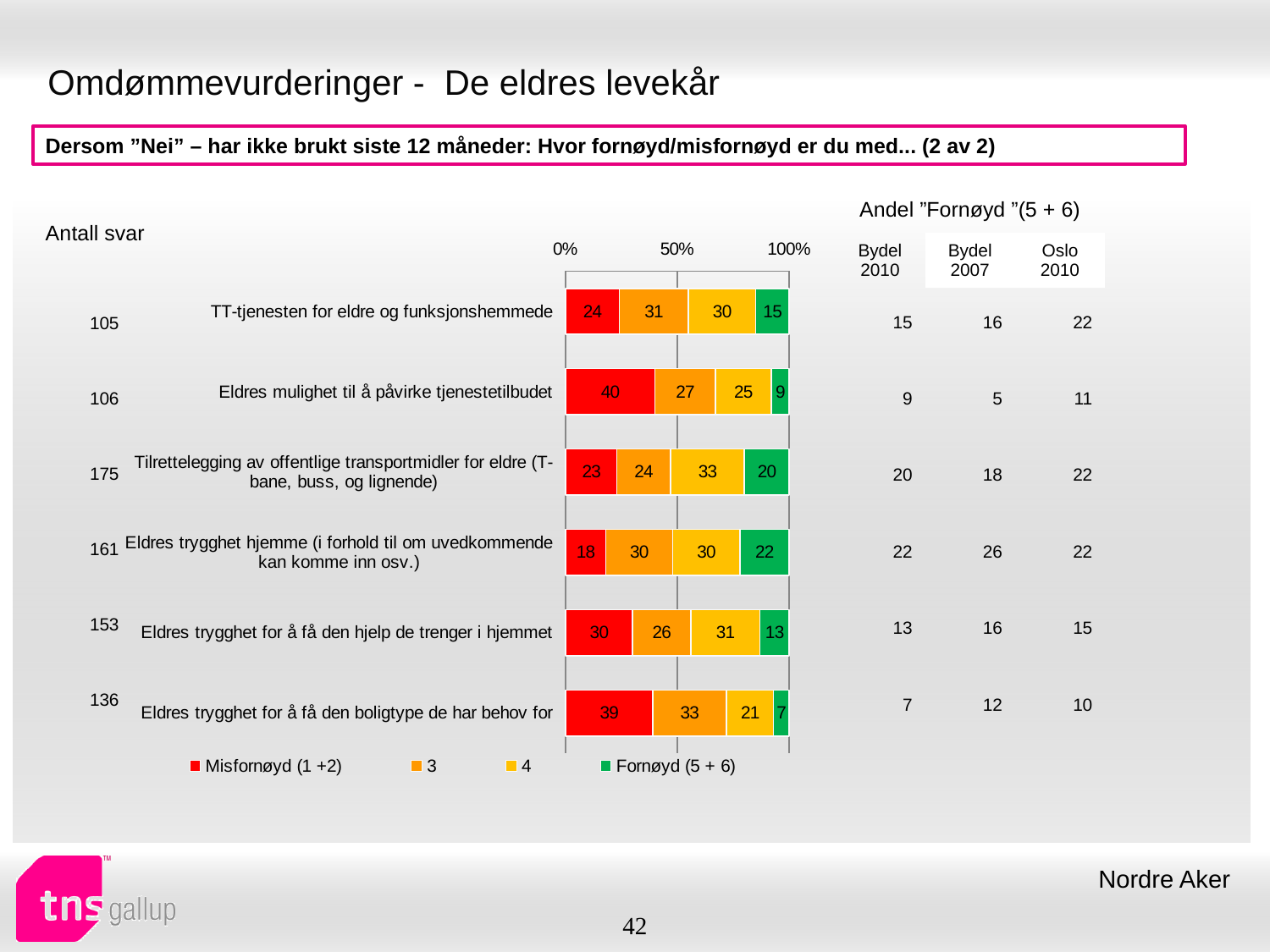
Which category has the highest Misfornøyd (1 +2) value? Eldres mulighet til å påvirke tjenestetilbudet What kind of chart is shown on the slide? Stacked bar chart How many series does the chart legend list? 4 What is the Misfornøyd (1 +2) value for 'TT-tjenesten for eldre og funksjonshemmede'? 24 What is the total of the stacked bar for 'Eldres mulighet til å påvirke tjenestetilbudet'? 101 What is the value of series '4' for 'Tilrettelegging av offentlige transportmidler for eldre (T-bane, buss, og lignende)'? 33 What is the Fornøyd (5 + 6) value for 'Eldres trygghet hjemme (i forhold til om uvedkommende kan komme inn osv.)'? 22 What is the difference between the Misfornøyd (1 +2) values for 'Eldres trygghet for å få den boligtype de har behov for' and 'Eldres trygghet hjemme (i forhold til om uvedkommende kan komme inn osv.)'? 21 Which is larger: the Fornøyd (5 + 6) value for 'TT-tjenesten for eldre og funksjonshemmede' or for 'Eldres trygghet for å få den hjelp de trenger i hjemmet'? TT-tjenesten for eldre og funksjonshemmede Which colour represents the Fornøyd (5 + 6) series in the chart? Green How many categories (bars) are plotted in the chart? 6 Which category has the lowest Fornøyd (5 + 6) value? Eldres trygghet for å få den boligtype de har behov for